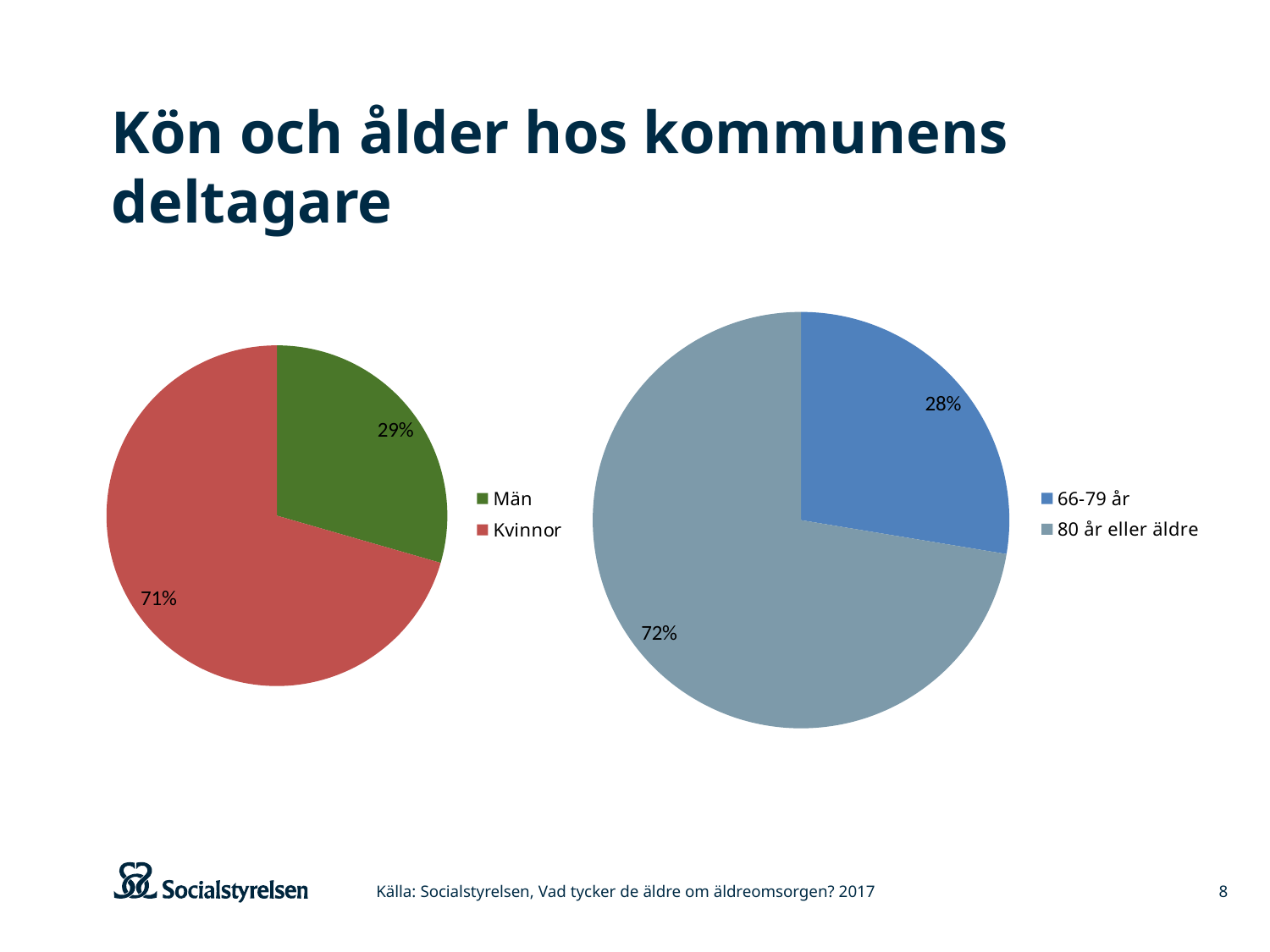
In the right pie chart (age), what is the difference in percentage points between 80 år eller äldre and 66-79 år? 44 percentage points In the left pie chart (gender), what share of participants are Män? 29% Which is larger: the share of Män in the left pie chart or the share of 66-79 år in the right pie chart? Män In the right pie chart (age), what share of participants are 66-79 år? 28% In the left pie chart (gender), which category has the largest share? Kvinnor In the right pie chart (age), what share of participants are 80 år eller äldre? 72% In the right pie chart (age), which category has the smallest share? 66-79 år What type of chart is used on this slide? Pie chart How many categories does the legend of the right pie chart (age) list? 2 In the left pie chart (gender), what is the difference in percentage points between Kvinnor and Män? 42 percentage points In the left pie chart (gender), what colour is the Kvinnor slice? Red In the left pie chart (gender), what share of participants are Kvinnor? 71%